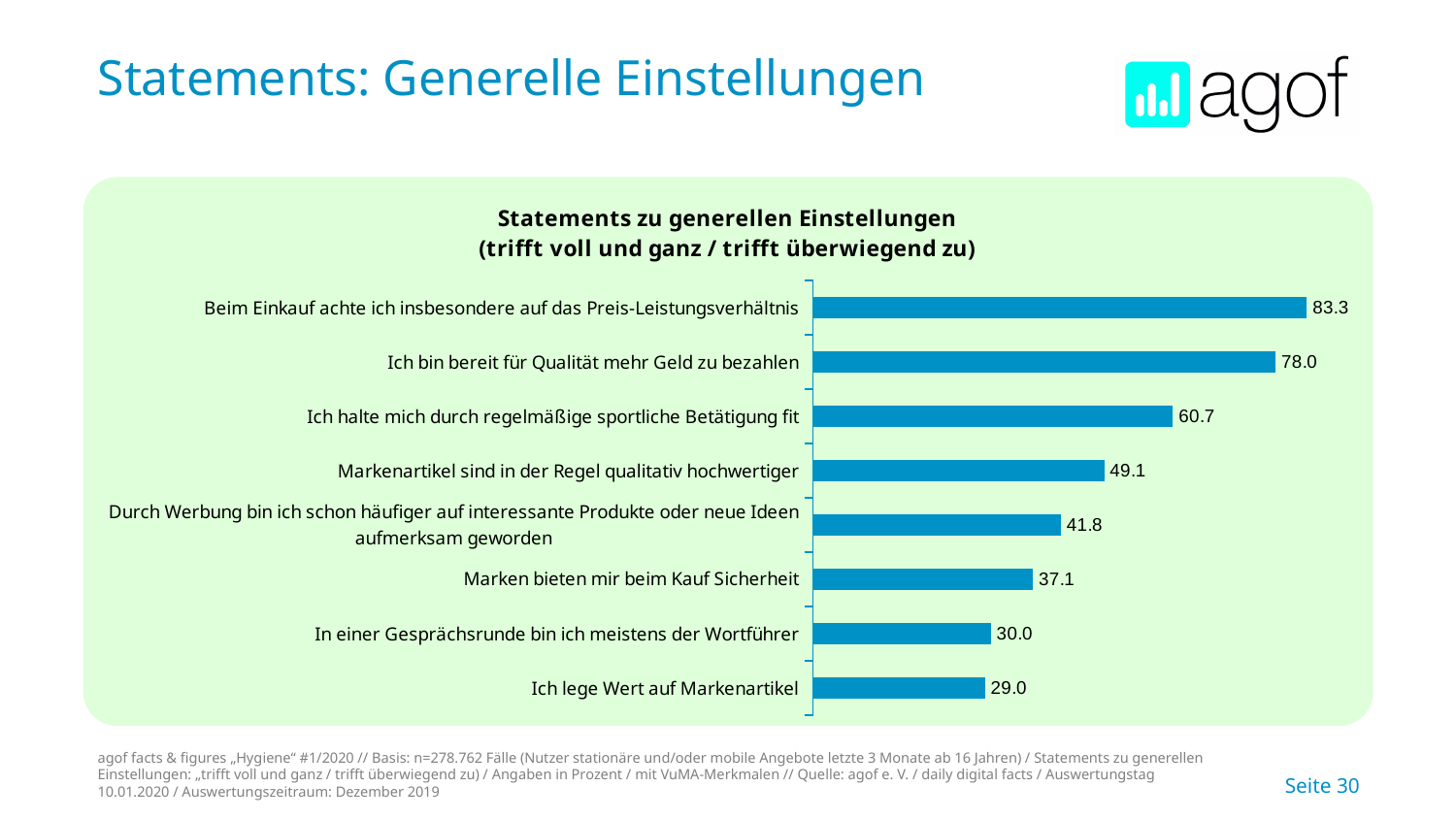
What is the value for "Ich halte mich durch regelmäßige sportliche Betätigung fit"? 60.7 Which statement has the lowest value? Ich lege Wert auf Markenartikel What is the value for "Beim Einkauf achte ich insbesondere auf das Preis-Leistungsverhältnis"? 83.3 Which is larger: the value for "In einer Gesprächsrunde bin ich meistens der Wortführer" or for "Ich lege Wert auf Markenartikel"? In einer Gesprächsrunde bin ich meistens der Wortführer What is the difference between the values for "Ich bin bereit für Qualität mehr Geld zu bezahlen" and "Markenartikel sind in der Regel qualitativ hochwertiger"? 28.9 What is the title of the chart? Statements zu generellen Einstellungen (trifft voll und ganz / trifft überwiegend zu) What is the value for "Durch Werbung bin ich schon häufiger auf interessante Produkte oder neue Ideen aufmerksam geworden"? 41.8 What is the difference between the values for "Beim Einkauf achte ich insbesondere auf das Preis-Leistungsverhältnis" and "Ich bin bereit für Qualität mehr Geld zu bezahlen"? 5.3 What kind of chart is shown on the slide? Bar chart What is the value for "Marken bieten mir beim Kauf Sicherheit"? 37.1 Which statement has the highest value? Beim Einkauf achte ich insbesondere auf das Preis-Leistungsverhältnis How many statements are shown in the chart? 8